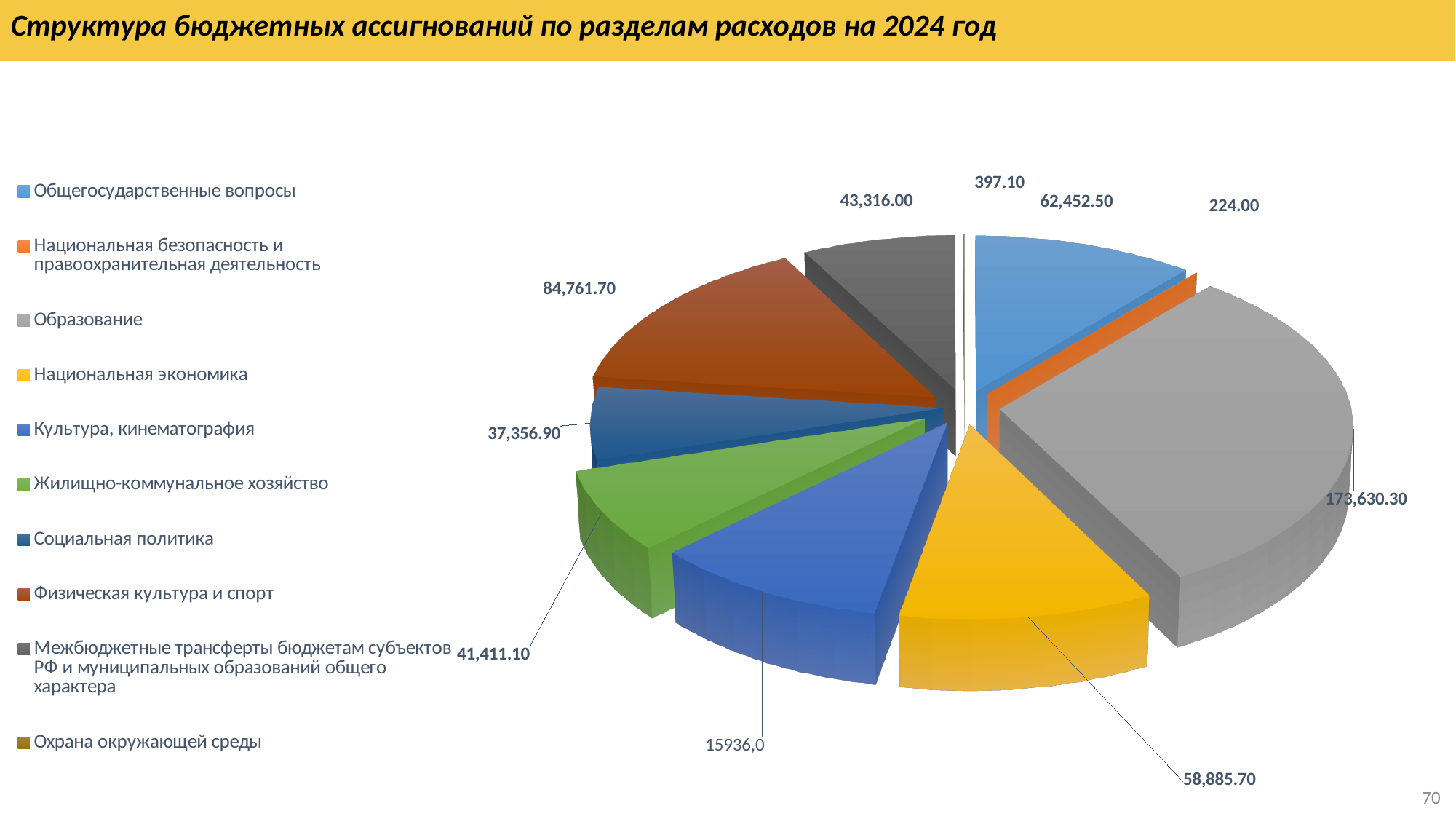
What is the value for Социальная политика? 37,356.90 What is the value for Физическая культура и спорт? 84,761.70 How many categories does the legend list? 10 Which category has the largest value? Образование What is the difference between the values for Образование and Физическая культура и спорт? 88,868.60 What kind of chart is shown on the slide? Pie chart What is the value for Охрана окружающей среды? 397.10 Which is larger, the value for Жилищно-коммунальное хозяйство or the value for Социальная политика? Жилищно-коммунальное хозяйство What is the difference between the values for Общегосударственные вопросы and Национальная экономика? 3,566.80 What is the title of the chart? Структура бюджетных ассигнований по разделам расходов на 2024 год What is the value for Образование? 173,630.30 Which category has the smallest value? Национальная безопасность и правоохранительная деятельность